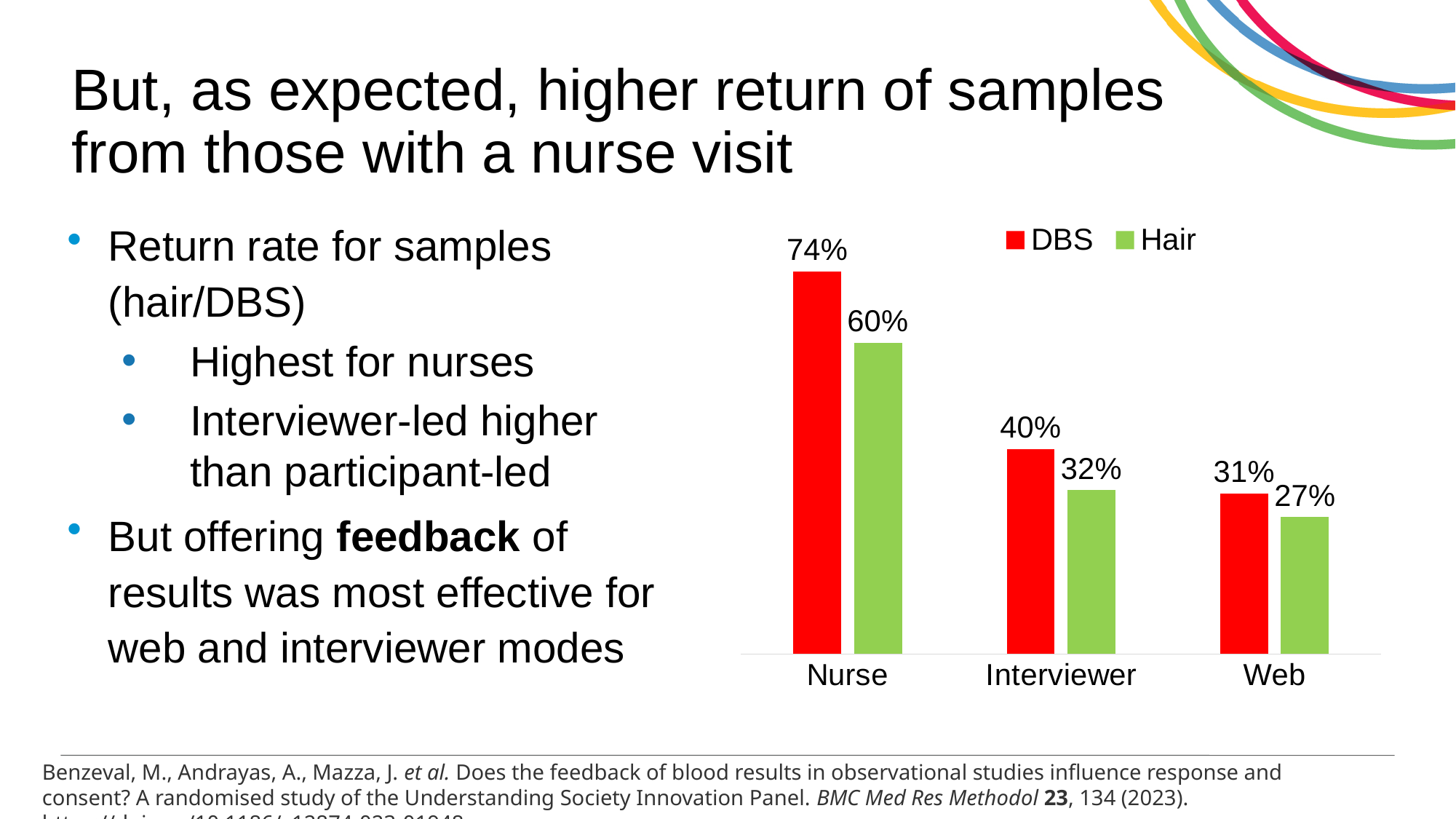
Which colour represents the DBS series in the chart? Red How many series does the chart legend list? 2 What is the Hair return rate for the Web mode? 27% Which is larger, the Hair return rate for Nurse or the DBS return rate for Interviewer? Hair return rate for Nurse What is the Hair return rate for the Interviewer mode? 32% What is the difference between the DBS and Hair return rates for the Nurse mode? 14% Which mode has the lowest Hair return rate? Web What kind of chart is shown on the slide? Bar chart How many modes are shown on the x axis of the chart? 3 What is the difference between the DBS return rates for Interviewer and Web? 9% Which mode has the highest DBS return rate? Nurse What is the DBS return rate for the Nurse mode? 74%